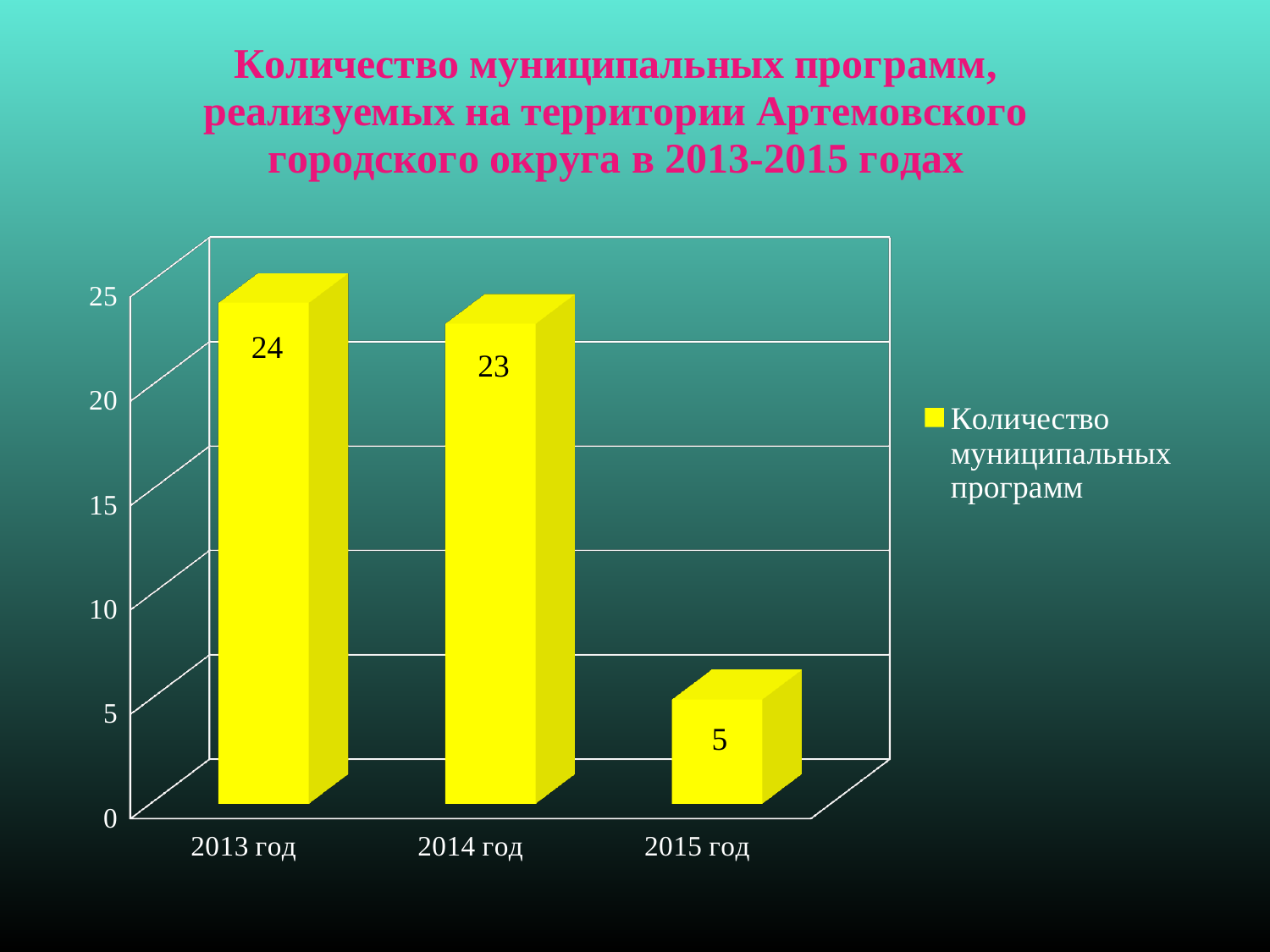
What is the difference between the values for 2013 год and 2015 год? 19 What kind of chart is shown on the slide? bar chart Which year has the highest number of municipal programmes? 2013 год How many categories are shown on the x axis? 3 Do the values rise or fall from 2013 год to 2015 год? fall What is the value for 2015 год? 5 Is the value for 2015 год greater or less than 10? less Which is larger, the value for 2014 год or the value for 2015 год? 2014 год What is the difference between the values for 2013 год and 2014 год? 1 What is the value for 2014 год? 23 What is the value for 2013 год? 24 Which year has the lowest number of municipal programmes? 2015 год